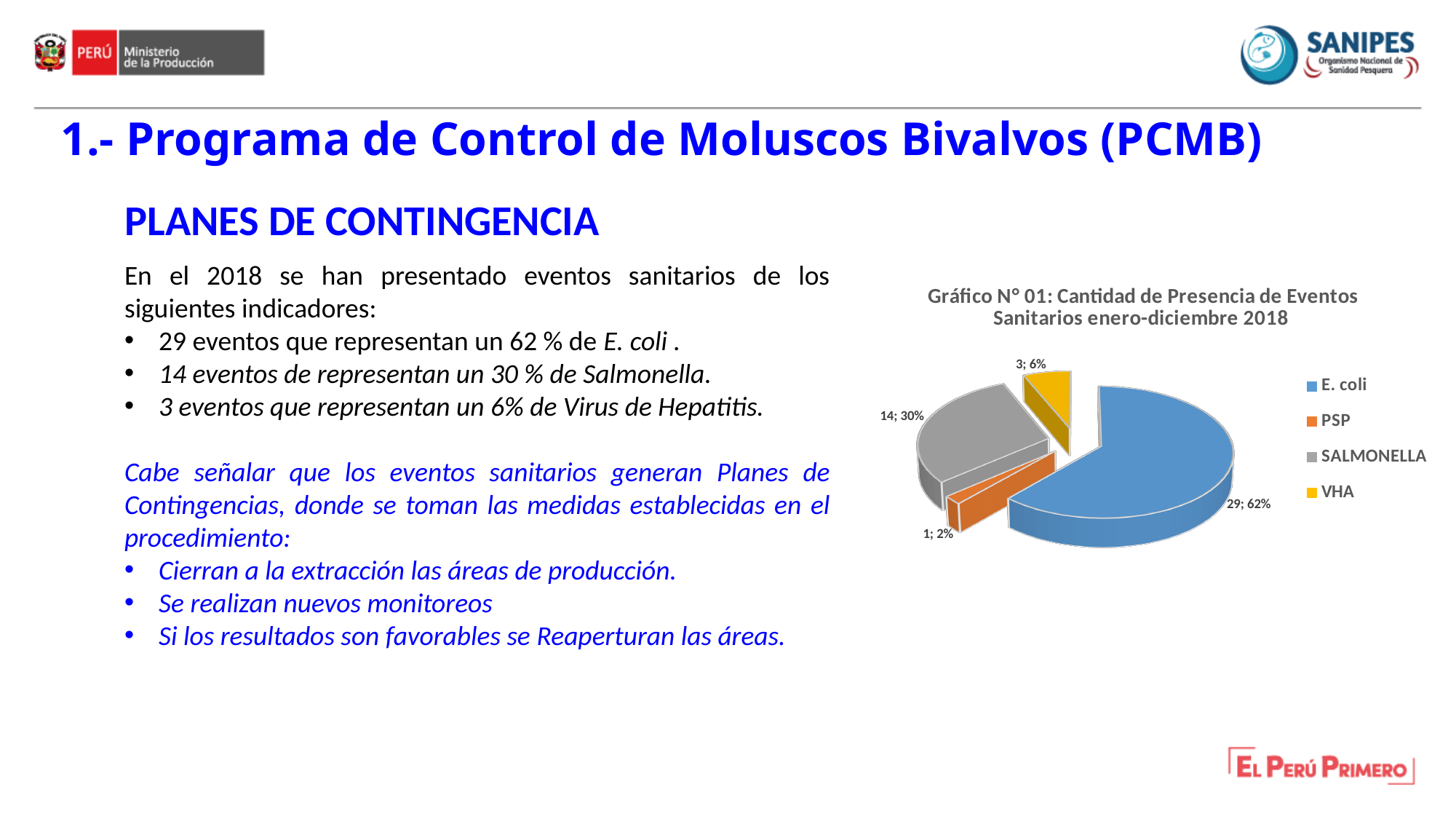
What percentage share of the pie does VHA represent? 6% How many categories does the legend of the pie chart list? 4 What kind of chart is shown on the slide? pie chart Which category has the largest slice in the pie chart? E. coli Which category has the smallest slice in the pie chart? PSP How many events are shown for E. coli in the pie chart? 29 What is the difference in number of events between E. coli and SALMONELLA? 15 What is the title of the chart? Gráfico N° 01: Cantidad de Presencia de Eventos Sanitarios enero-diciembre 2018 How many events are shown for SALMONELLA in the pie chart? 14 How many events are shown for PSP in the pie chart? 1 What percentage share of the pie does E. coli represent? 62% Which has more events, SALMONELLA or VHA? SALMONELLA